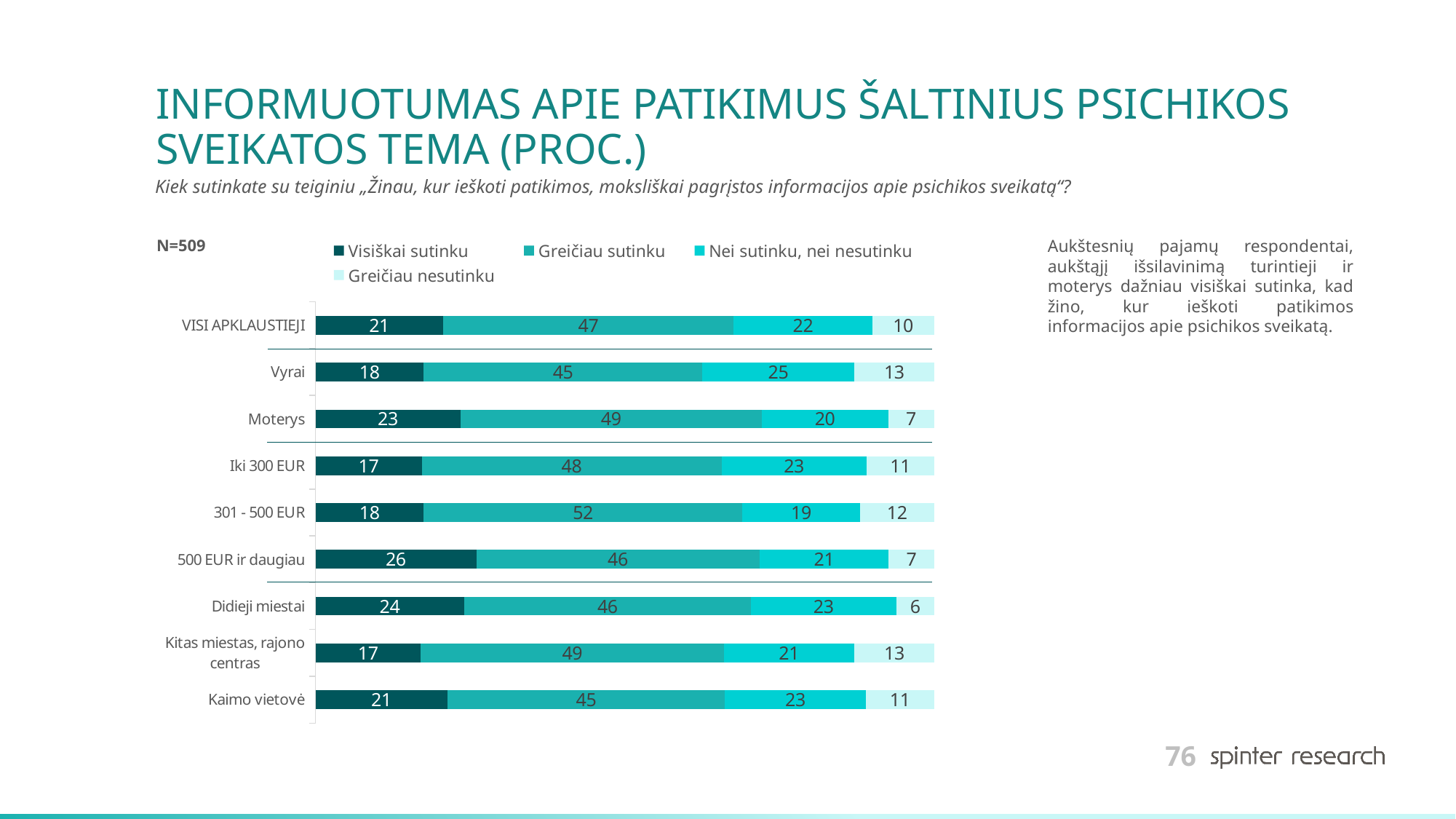
What is the difference between the "Visiškai sutinku" values for Moterys and Vyrai? 5 Which category has the lowest "Greičiau nesutinku" value? Didieji miestai What kind of chart is shown on the slide? Stacked bar chart What is the "Greičiau nesutinku" value for Didieji miestai? 6 Which category has the highest "Visiškai sutinku" value? 500 EUR ir daugiau What is the total of the stacked bar for VISI APKLAUSTIEJI? 100 Which has a larger "Nei sutinku, nei nesutinku" value, Vyrai or Moterys? Vyrai How many categories are plotted on the chart? 9 What is the "Visiškai sutinku" value for VISI APKLAUSTIEJI? 21 How many series does the legend list? 4 What is the "Greičiau sutinku" value for 301 - 500 EUR? 52 What is the sample size (N) shown on the slide? N=509